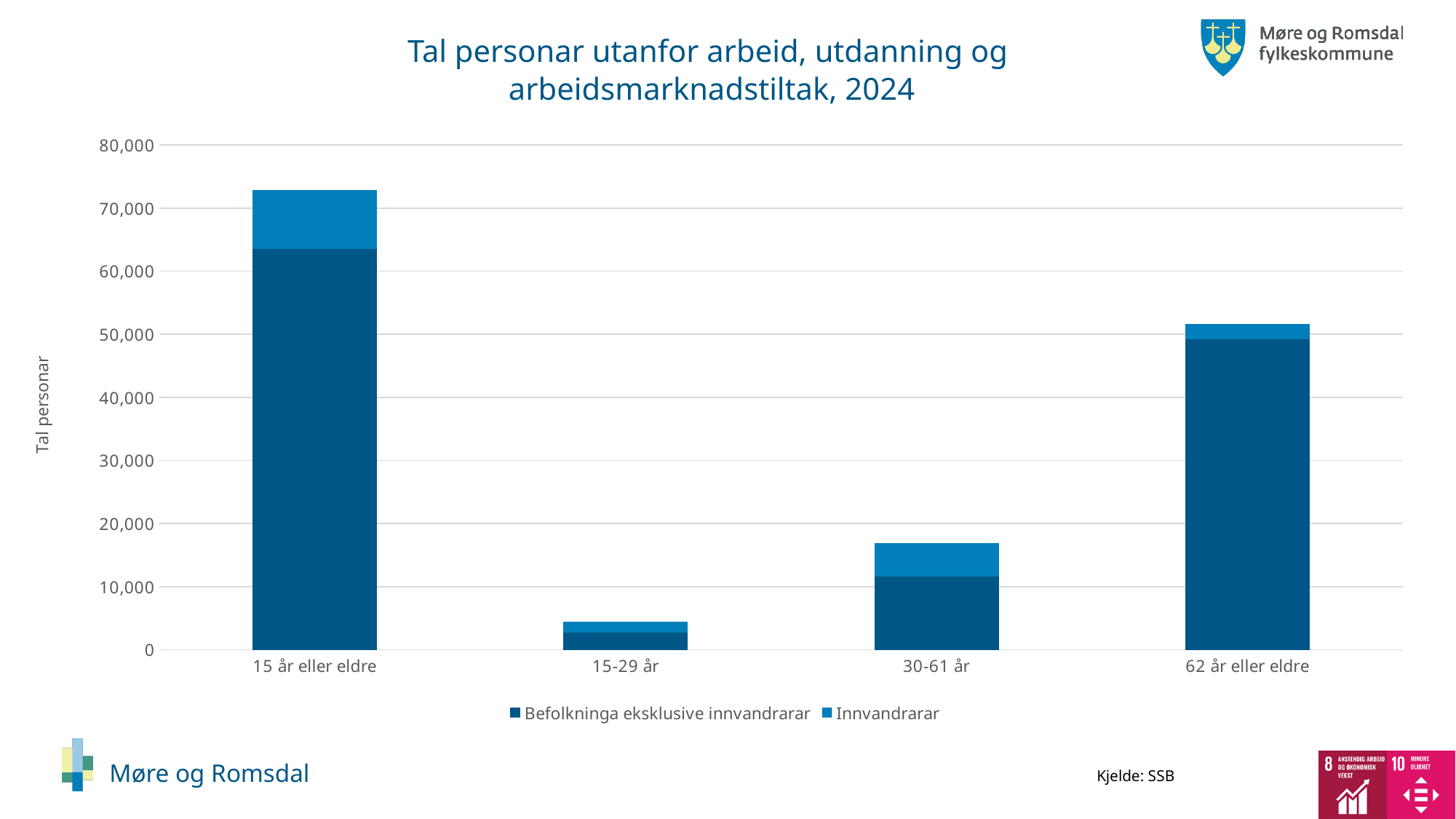
Which age category has the highest total bar? 15 år eller eldre Is the total value for 15-29 år greater or less than 10,000? less Is the total value for 15 år eller eldre greater or less than 70,000? greater What is the title of the chart? Tal personar utanfor arbeid, utdanning og arbeidsmarknadstiltak, 2024 Is the total value for 30-61 år greater or less than 20,000? less How many series does the legend list? 2 How many age categories are shown on the x axis? 4 What is the label of the y axis? Tal personar What kind of chart is shown on the slide? Stacked bar chart Which is larger, the total bar for 30-61 år or the total bar for 62 år eller eldre? 62 år eller eldre Which age category has the lowest total bar? 15-29 år